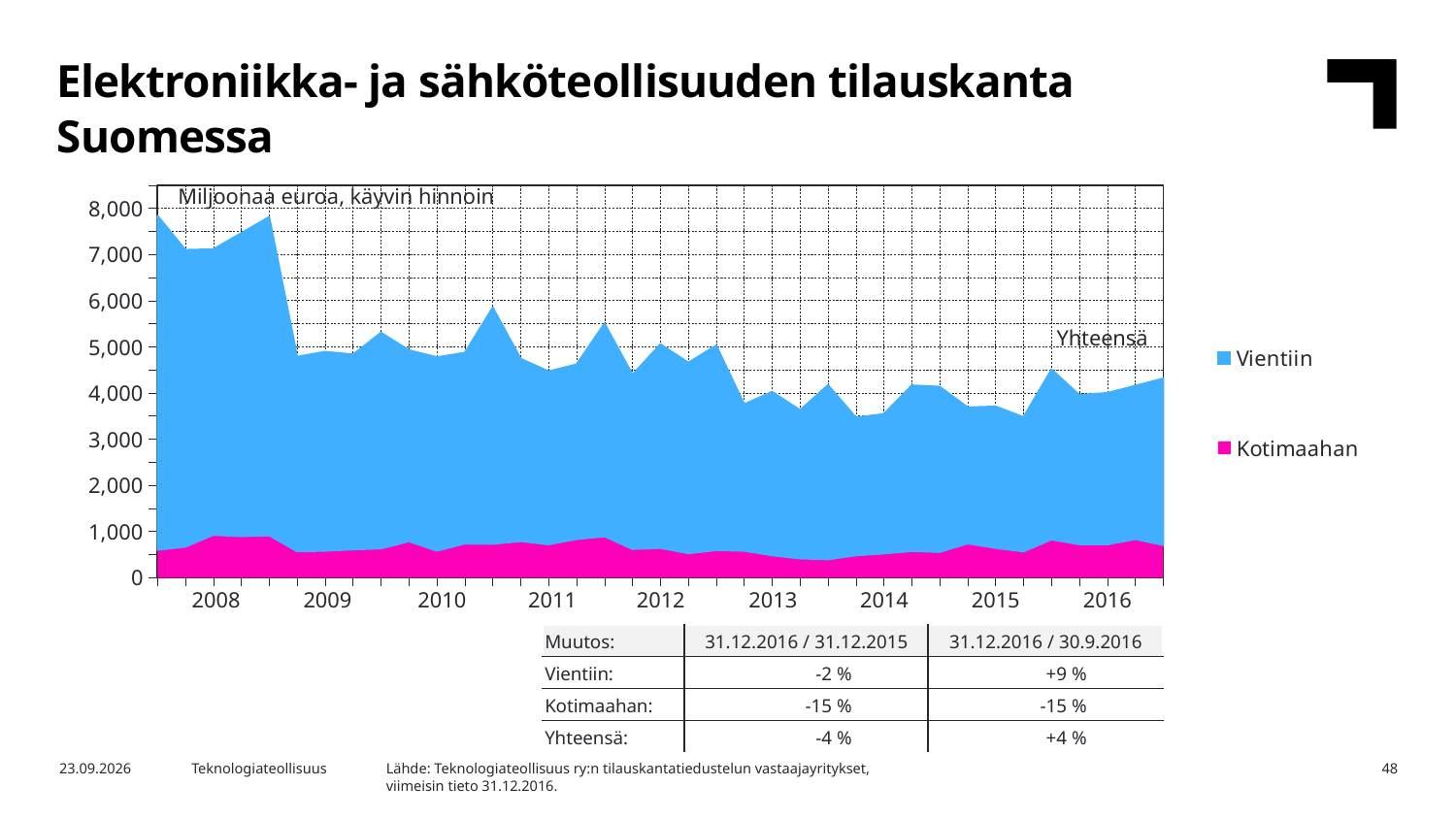
What unit label is printed at the top of the chart? Miljoonaa euroa, käyvin hinnoin Is the total (Yhteensä) value at the end of 2016 greater or less than 3,000? greater Which two series are listed in the chart legend? Vientiin and Kotimaahan What kind of chart is shown on the slide? Area chart Is the total (Yhteensä) value during 2014 greater or less than 5,000? less Is the total (Yhteensä) value at the start of 2008 greater or less than 7,000? greater According to the table below the chart, what is the change in Vientiin for 31.12.2016 / 30.9.2016? +9 % How many series does the legend list? 2 Does the total order backlog (Yhteensä) rise or fall overall from 2008 to 2016? fall How many years are labelled on the x axis of the chart? 9 Which series is larger throughout the chart, Vientiin or Kotimaahan? Vientiin